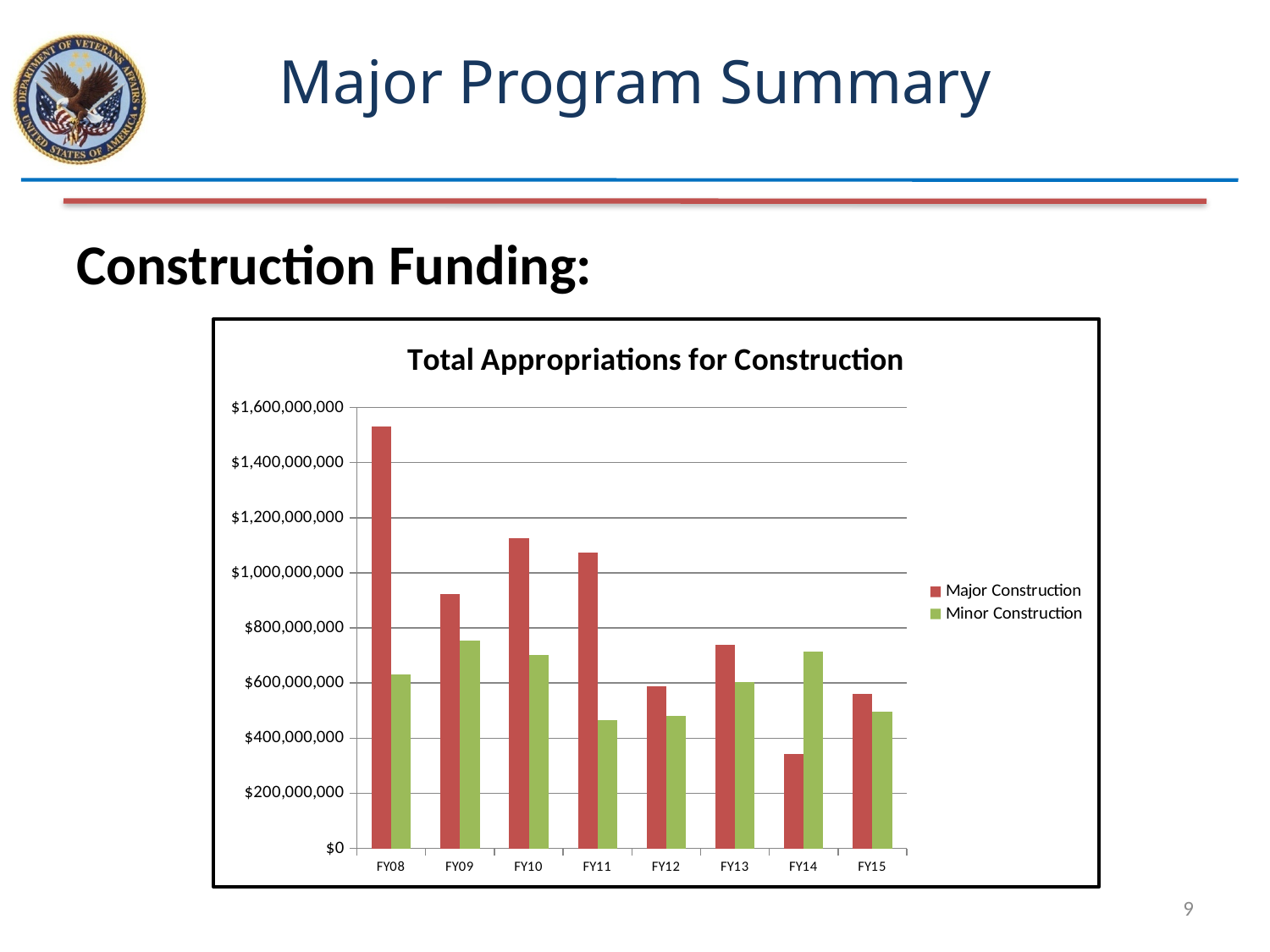
Which fiscal year has the lowest Major Construction appropriation? FY14 Is the Major Construction value for FY14 greater or less than $400,000,000? less Is the Minor Construction value for FY09 greater or less than $800,000,000? less In FY08, which is larger: Major Construction or Minor Construction? Major Construction What is the title of the chart? Total Appropriations for Construction Is the Major Construction value for FY08 greater or less than $1,400,000,000? greater What kind of chart is shown on the slide? bar chart In FY14, which is larger: Major Construction or Minor Construction? Minor Construction How many series does the legend list? 2 How many fiscal years are shown on the x axis? 8 Which fiscal year has the highest Major Construction appropriation? FY08